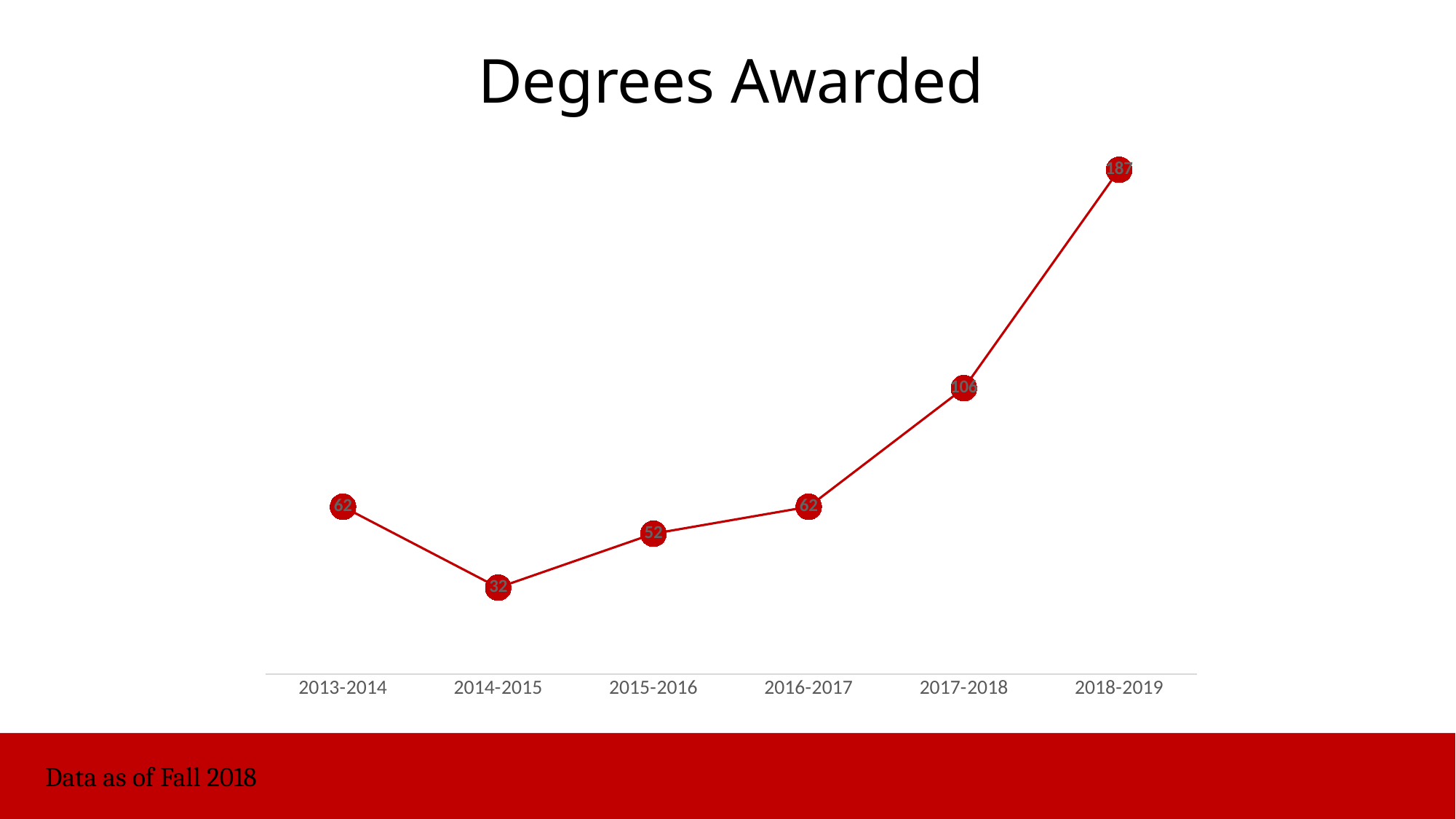
How many academic years are plotted on the chart? 6 What type of chart is shown on the slide? line chart How many degrees were awarded in 2018-2019? 187 What is the value for 2015-2016? 52 What is the difference between the degrees awarded in 2013-2014 and 2014-2015? 30 Which academic year has the highest number of degrees awarded? 2018-2019 What is the title of the chart? Degrees Awarded How many degrees were awarded in 2017-2018? 106 What is the difference between the degrees awarded in 2018-2019 and 2017-2018? 81 How many degrees were awarded in 2014-2015? 32 Which year had more degrees awarded, 2015-2016 or 2016-2017? 2016-2017 Which academic year has the lowest number of degrees awarded? 2014-2015